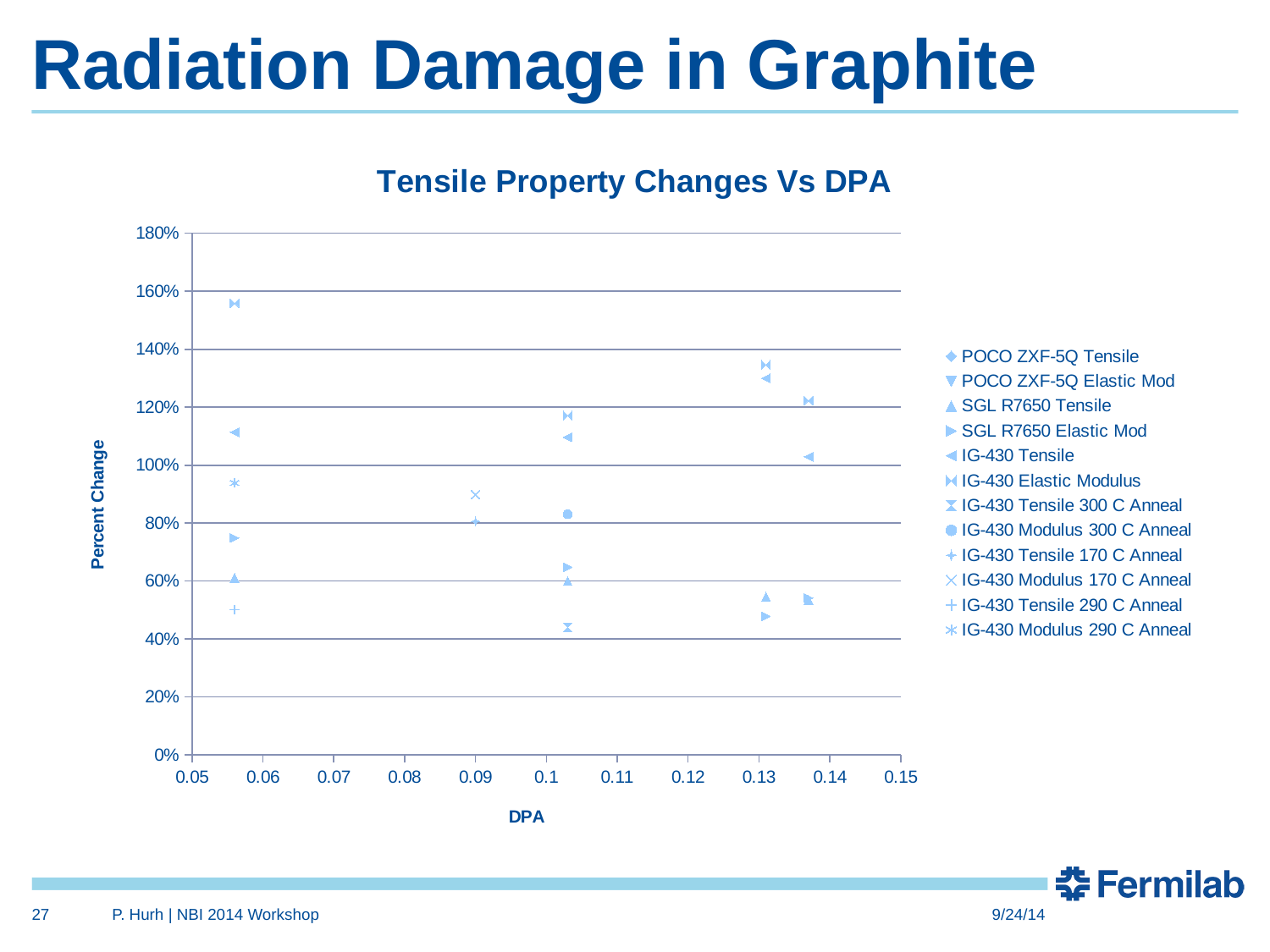
Near DPA 0.056, which is larger: the IG-430 Modulus 290 C Anneal point or the IG-430 Tensile 290 C Anneal point? IG-430 Modulus 290 C Anneal Is the IG-430 Tensile point near DPA 0.056 greater or less than 100%? greater What is the title of the chart? Tensile Property Changes Vs DPA Is the IG-430 Tensile 300 C Anneal point near DPA 0.103 greater or less than 60%? less Which series has the highest plotted point on the chart? IG-430 Elastic Modulus Is the IG-430 Tensile 290 C Anneal point near DPA 0.056 greater or less than 60%? less Near DPA 0.056, which is larger: the IG-430 Elastic Modulus point or the IG-430 Tensile point? IG-430 Elastic Modulus How many series does the legend list? 12 What kind of chart is shown on the slide? Scatter chart What is the label on the vertical axis? Percent Change